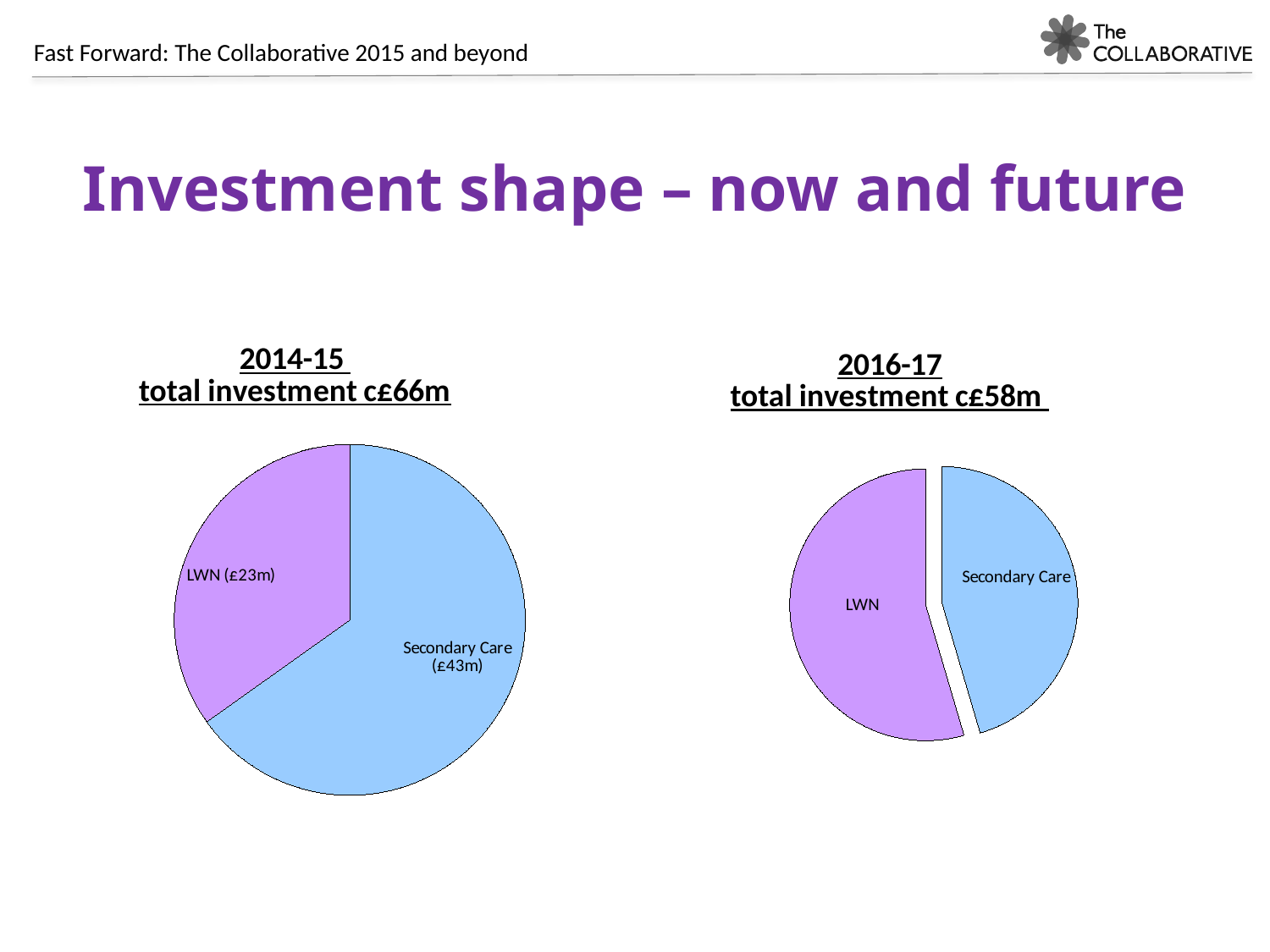
In the 2014-15 chart on the left, which category has the largest slice? Secondary Care In the 2014-15 chart on the left, what is the value for Secondary Care? £43m In the 2014-15 chart on the left, what is the value for LWN? £23m What total investment is stated in the title of the 2016-17 chart on the right? c£58m What kind of chart is the 2014-15 chart on the left? pie chart How many slices does the 2016-17 chart on the right have? 2 What total investment is stated in the title of the 2014-15 chart on the left? c£66m In the 2014-15 chart on the left, what is the difference between Secondary Care and LWN? £20m How many slices does the 2014-15 chart on the left have? 2 In the 2014-15 chart on the left, which is larger, LWN or Secondary Care? Secondary Care In the 2014-15 chart on the left, which category has the smallest slice? LWN